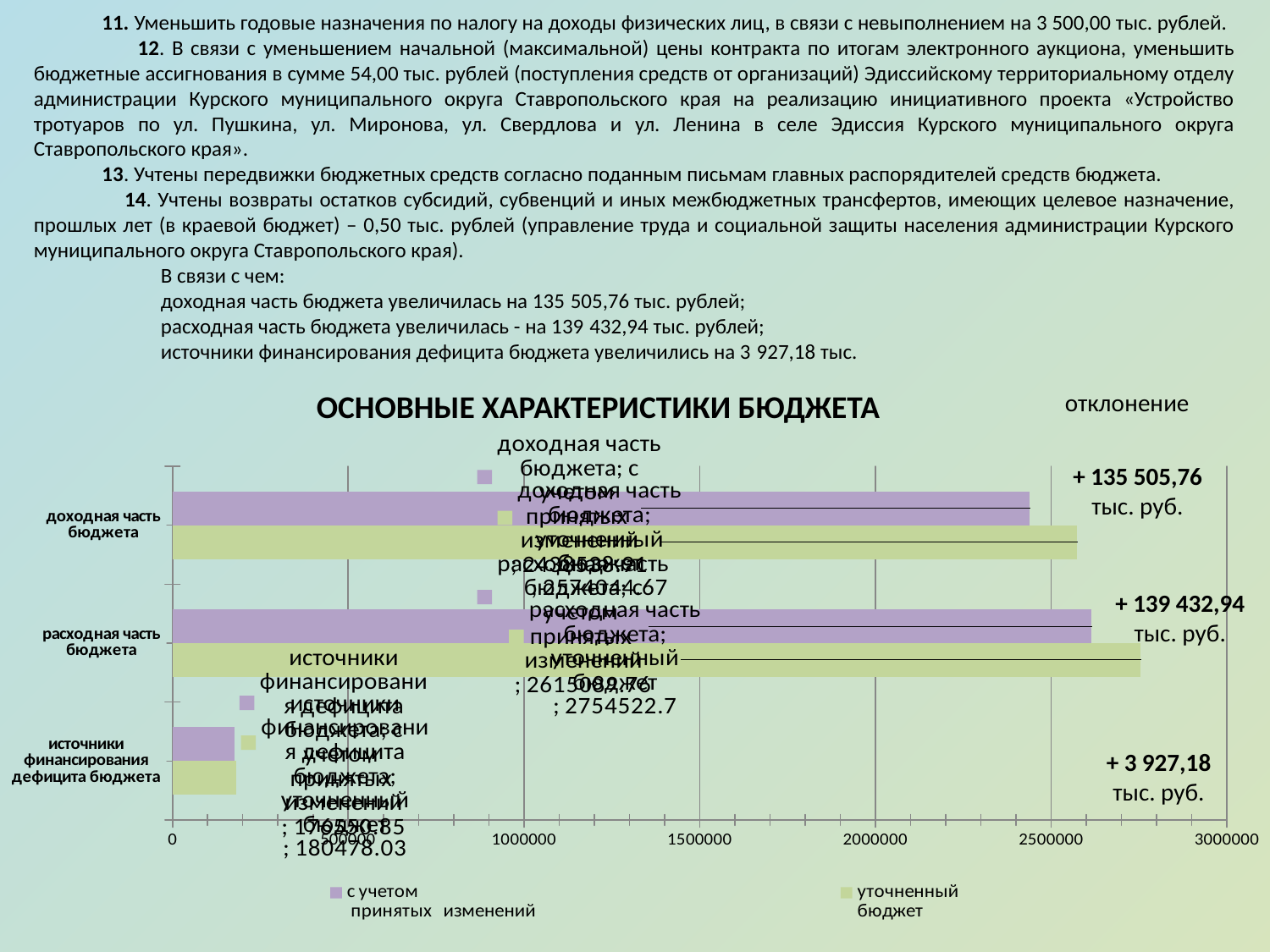
Which category has the lowest value in the 'с учетом принятых изменений' series? источники финансирования дефицита бюджета How many categories are shown on the chart? 3 Which category has the highest value in the 'уточненный бюджет' series? расходная часть бюджета Is the 'с учетом принятых изменений' value for 'доходная часть бюджета' greater or less than 2500000? less What deviation (отклонение) is shown next to 'источники финансирования дефицита бюджета'? + 3 927,18 тыс. руб. How many series does the chart legend list? 2 What type of chart is shown on the slide? bar chart For 'расходная часть бюджета', which series has the larger value: 'с учетом принятых изменений' or 'уточненный бюджет'? уточненный бюджет What deviation (отклонение) is shown next to 'доходная часть бюджета'? + 135 505,76 тыс. руб. Is the 'уточненный бюджет' value for 'расходная часть бюджета' greater or less than 2500000? greater Is the 'уточненный бюджет' value for 'источники финансирования дефицита бюджета' greater or less than 500000? less What is the title of the chart? ОСНОВНЫЕ ХАРАКТЕРИСТИКИ БЮДЖЕТА